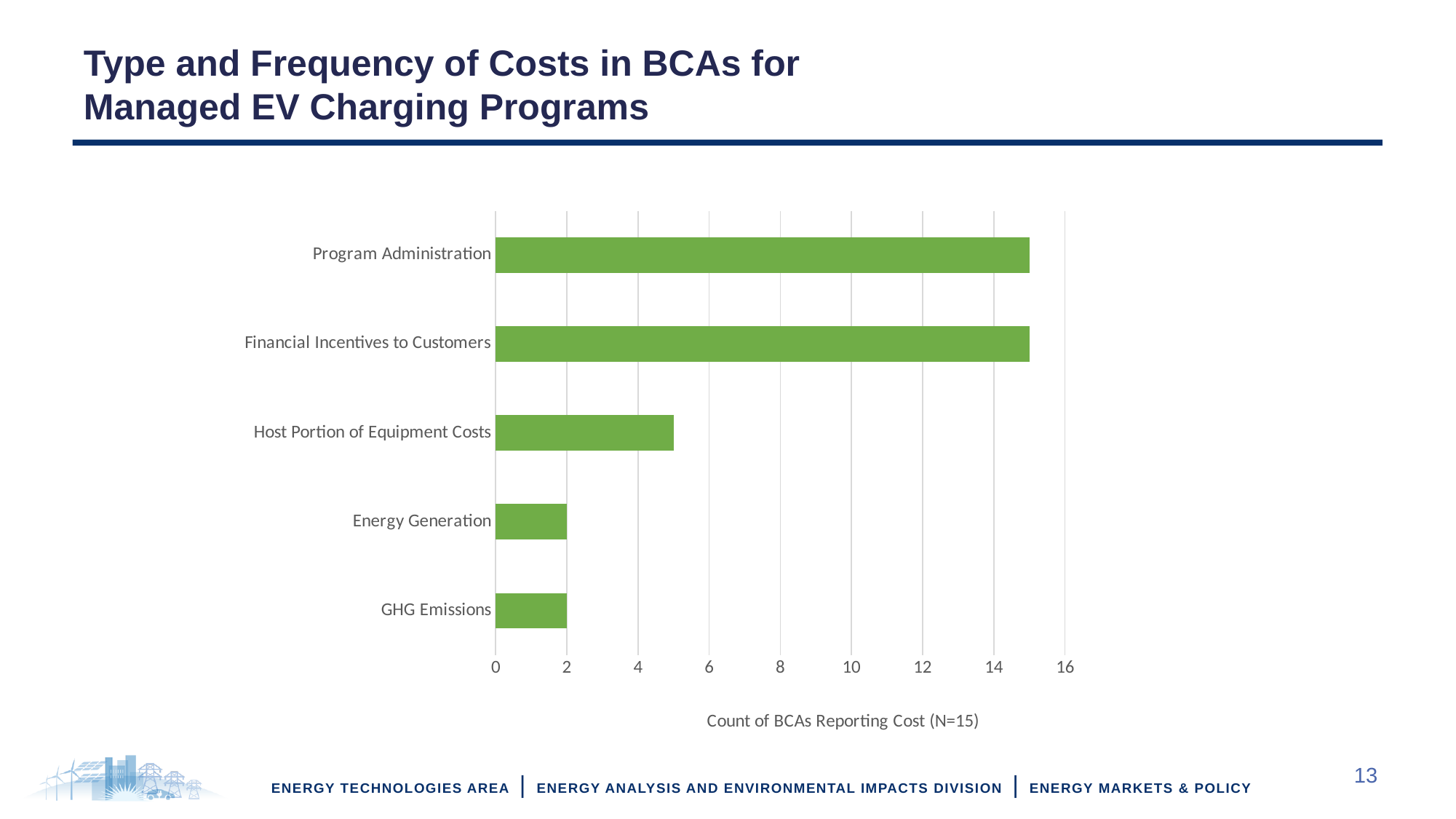
What is the count of BCAs reporting the Energy Generation cost? 2 What is the label on the horizontal axis of the chart? Count of BCAs Reporting Cost (N=15) Which has a higher count of BCAs: Program Administration or Host Portion of Equipment Costs? Program Administration How many cost categories are plotted in the chart? 5 Which has a higher count of BCAs: Host Portion of Equipment Costs or GHG Emissions? Host Portion of Equipment Costs Is the value for Financial Incentives to Customers greater or less than 16? less Is the value for Host Portion of Equipment Costs greater or less than 6? less What type of chart is shown on the slide? Bar chart What is the count of BCAs reporting the GHG Emissions cost? 2 Is the value for Program Administration greater or less than 14? greater What colour are the bars in the chart? Green